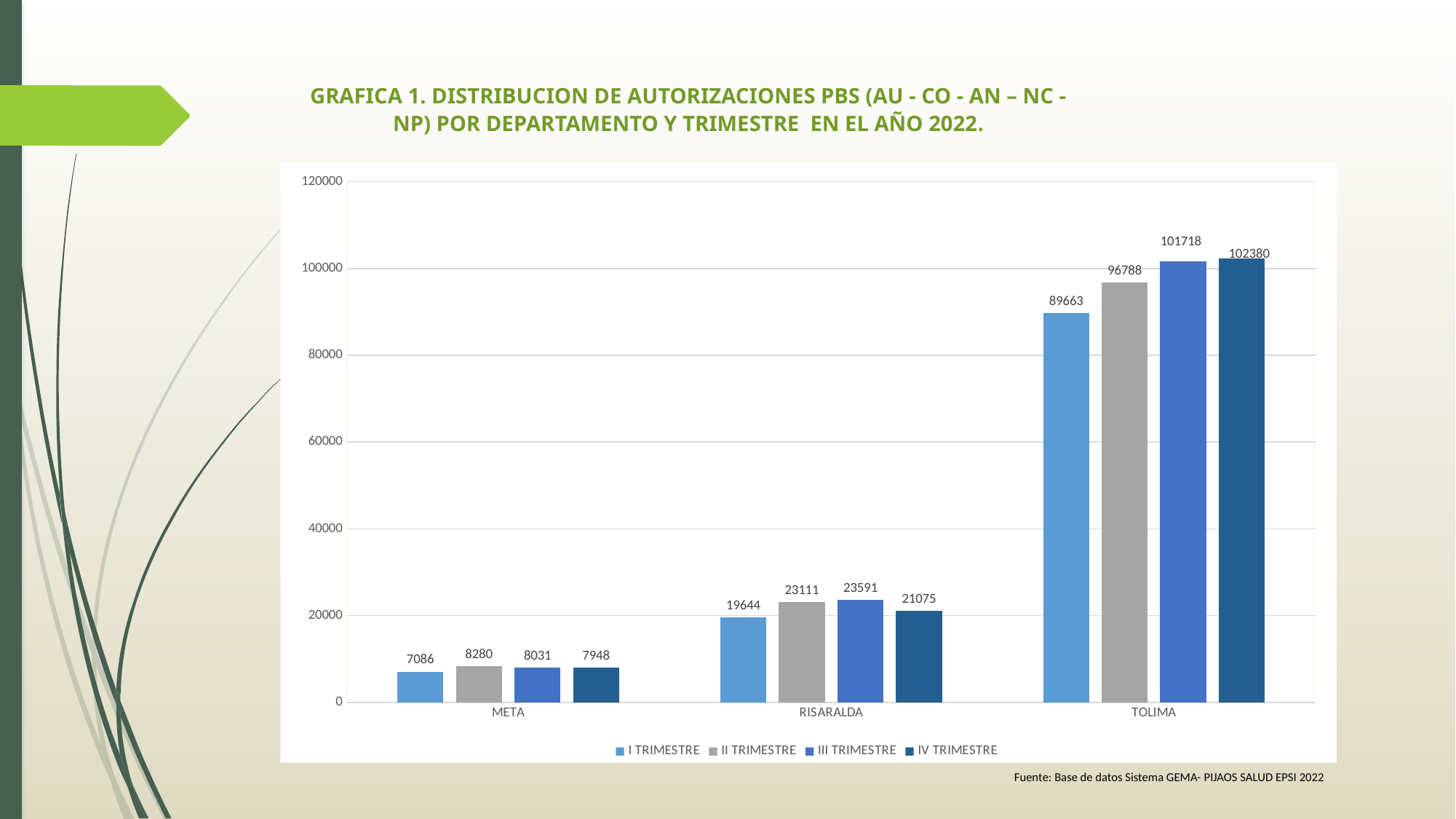
What is the source cited below the chart? Base de datos Sistema GEMA- PIJAOS SALUD EPSI 2022 How many departments are shown on the x axis? 3 What is the value for TOLIMA in IV TRIMESTRE? 102380 Which department has the lowest value in IV TRIMESTRE? META Which is larger for RISARALDA: the II TRIMESTRE value or the IV TRIMESTRE value? II TRIMESTRE What is the value for META in I TRIMESTRE? 7086 What kind of chart is shown on the slide? Bar chart Is the value for TOLIMA in III TRIMESTRE greater or less than 100000? greater How many series does the legend list? 4 What is the value for RISARALDA in III TRIMESTRE? 23591 What is the difference between the TOLIMA values for IV TRIMESTRE and I TRIMESTRE? 12717 Which department has the highest value in II TRIMESTRE? TOLIMA